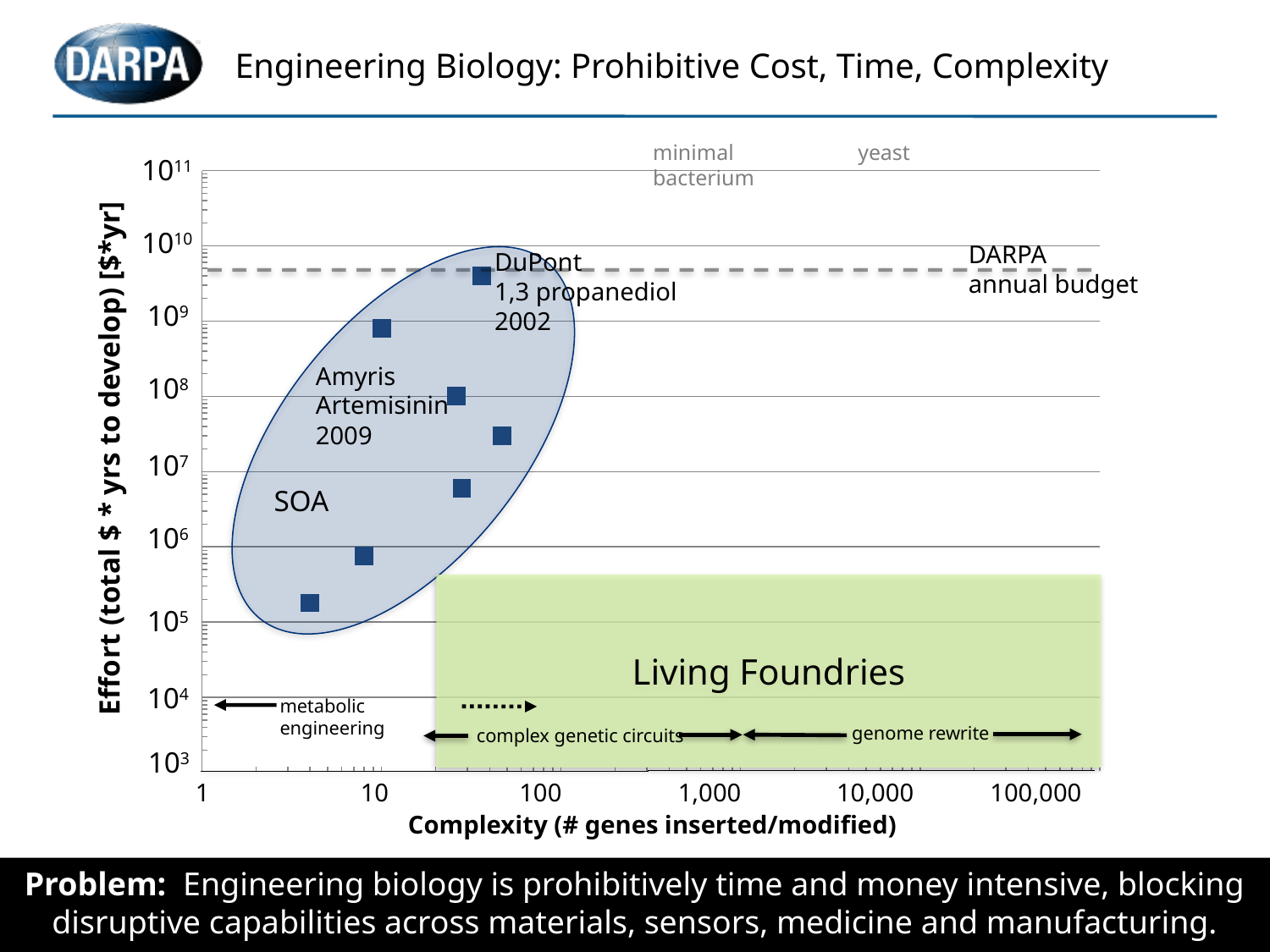
What is the title of the x axis? Complexity (# genes inserted/modified) Is the effort value of the lowest plotted point greater or less than 10^6? less Do the plotted effort values generally rise or fall as complexity increases along the x axis? rise What kind of chart is shown on the slide? scatter chart What is the title of the y axis? Effort (total $ * yrs to develop) [$*yr] Is the effort value for the DuPont 1,3 propanediol 2002 point greater or less than 10^9? greater How many data points are plotted on the chart? 7 Which labeled project has the highest effort value on the chart? DuPont 1,3 propanediol 2002 What is the largest value labeled on the x axis? 100,000 Which has the higher effort value, the DuPont 1,3 propanediol 2002 point or the Amyris Artemisinin 2009 point? DuPont 1,3 propanediol 2002 Is the DARPA annual budget dashed line above or below 10^9 on the y axis? above